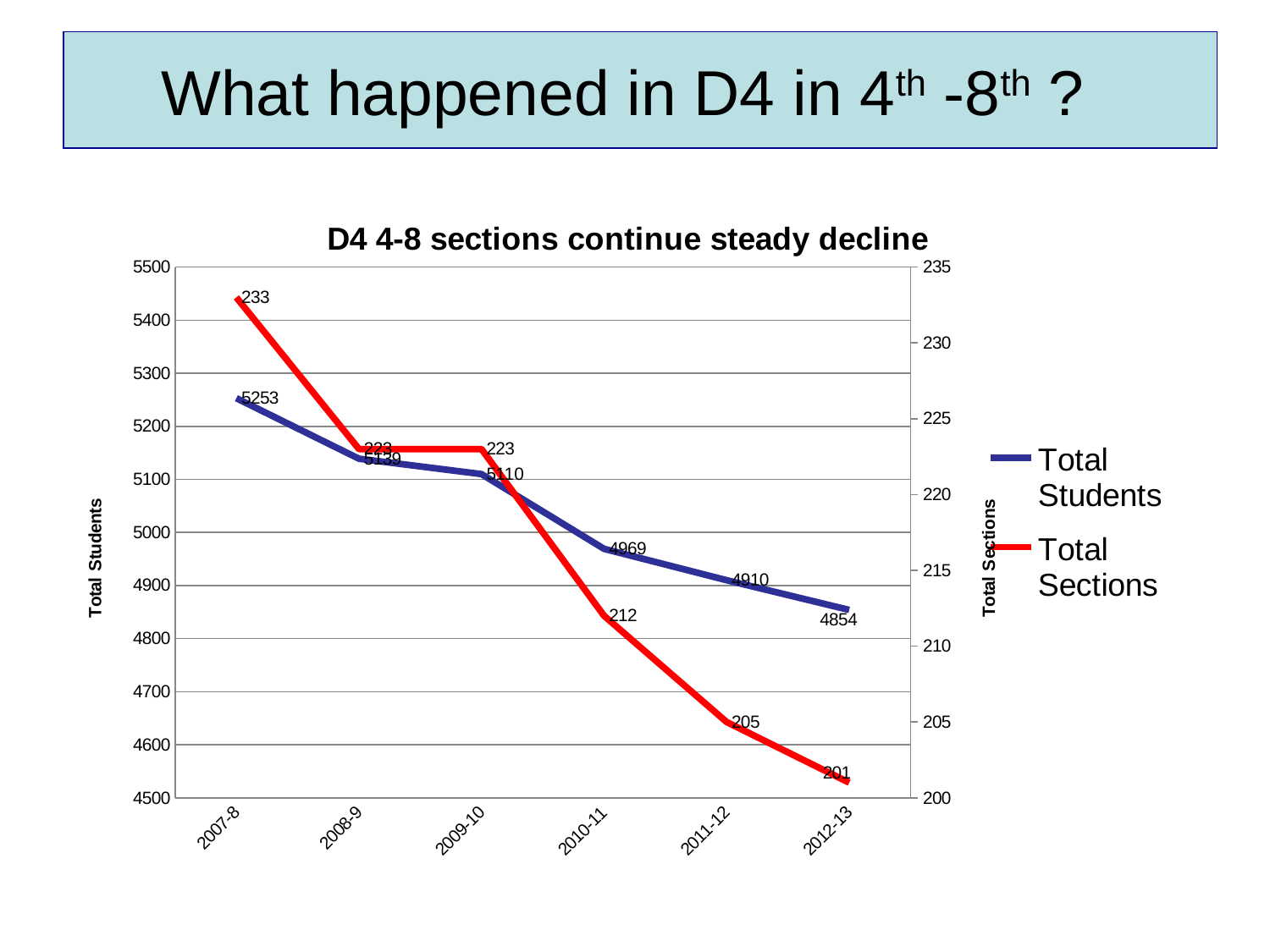
What is the value of Total Students in 2011-12? 4910 What is the value of Total Sections in 2012-13? 201 In which school year is Total Sections highest? 2007-8 In which school year is Total Students lowest? 2012-13 How many series does the legend list? 2 Does Total Students rise or fall from 2007-8 to 2012-13? fall What type of chart is shown on the slide? line chart What is the chart's title? D4 4-8 sections continue steady decline What is the value of Total Students in 2007-8? 5253 What is the difference between Total Sections in 2007-8 and 2012-13? 32 How many school years are plotted along the x axis? 6 What is the value of Total Sections in 2010-11? 212